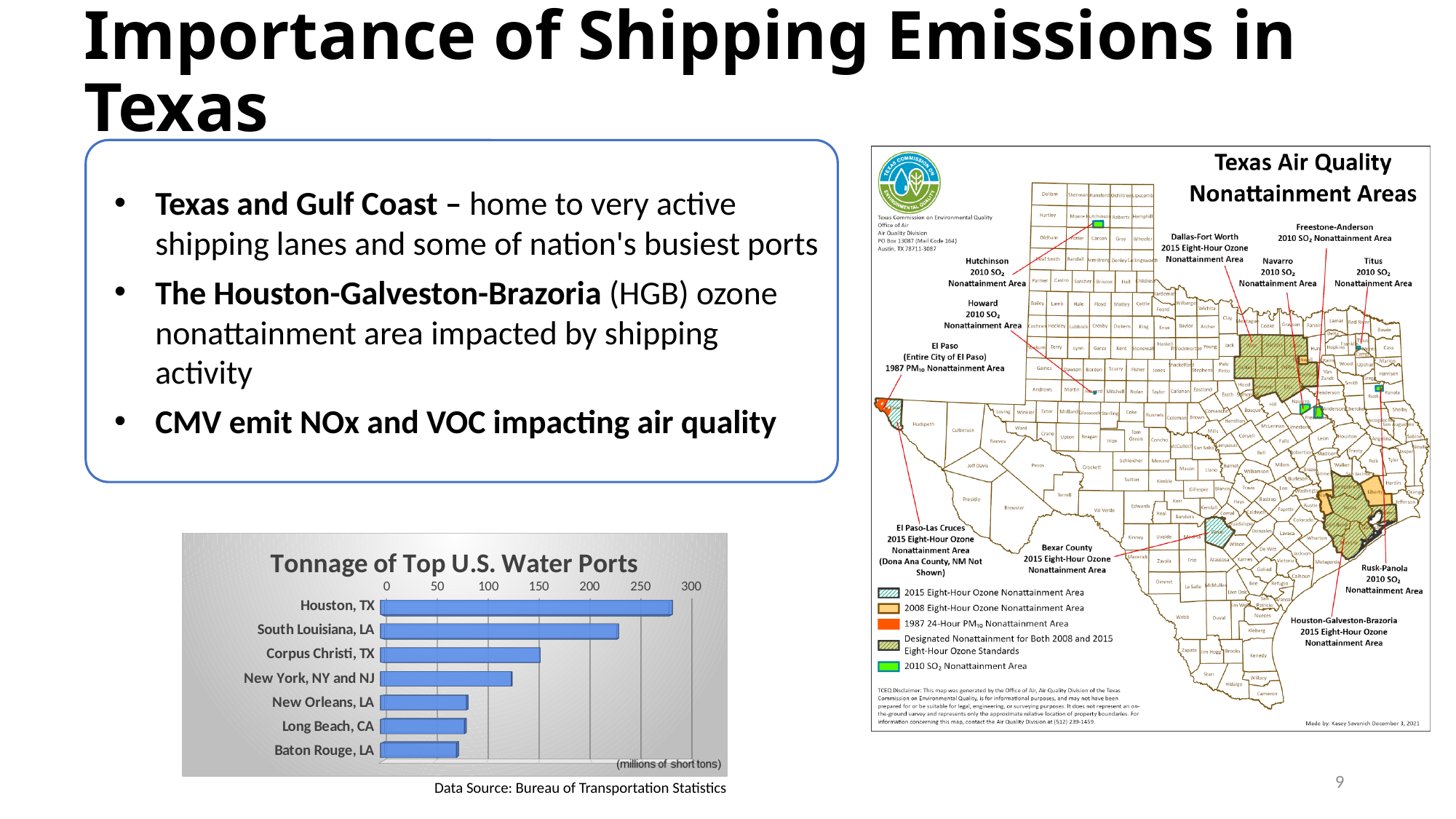
What kind of chart is the "Tonnage of Top U.S. Water Ports" chart? bar chart In the "Tonnage of Top U.S. Water Ports" chart, is the value for Baton Rouge, LA greater or less than 100? less In the "Tonnage of Top U.S. Water Ports" chart, is the value for Houston, TX greater or less than 250? greater In the "Tonnage of Top U.S. Water Ports" chart, is the value for South Louisiana, LA greater or less than 200? greater Which port has the highest tonnage in the "Tonnage of Top U.S. Water Ports" chart? Houston, TX What unit is the tonnage measured in on the "Tonnage of Top U.S. Water Ports" chart? millions of short tons In the "Tonnage of Top U.S. Water Ports" chart, which has the larger tonnage: Houston, TX or South Louisiana, LA? Houston, TX What is the data source given for the "Tonnage of Top U.S. Water Ports" chart? Bureau of Transportation Statistics How many ports are shown in the "Tonnage of Top U.S. Water Ports" chart? 7 In the "Tonnage of Top U.S. Water Ports" chart, which has the larger tonnage: Corpus Christi, TX or New York, NY and NJ? Corpus Christi, TX